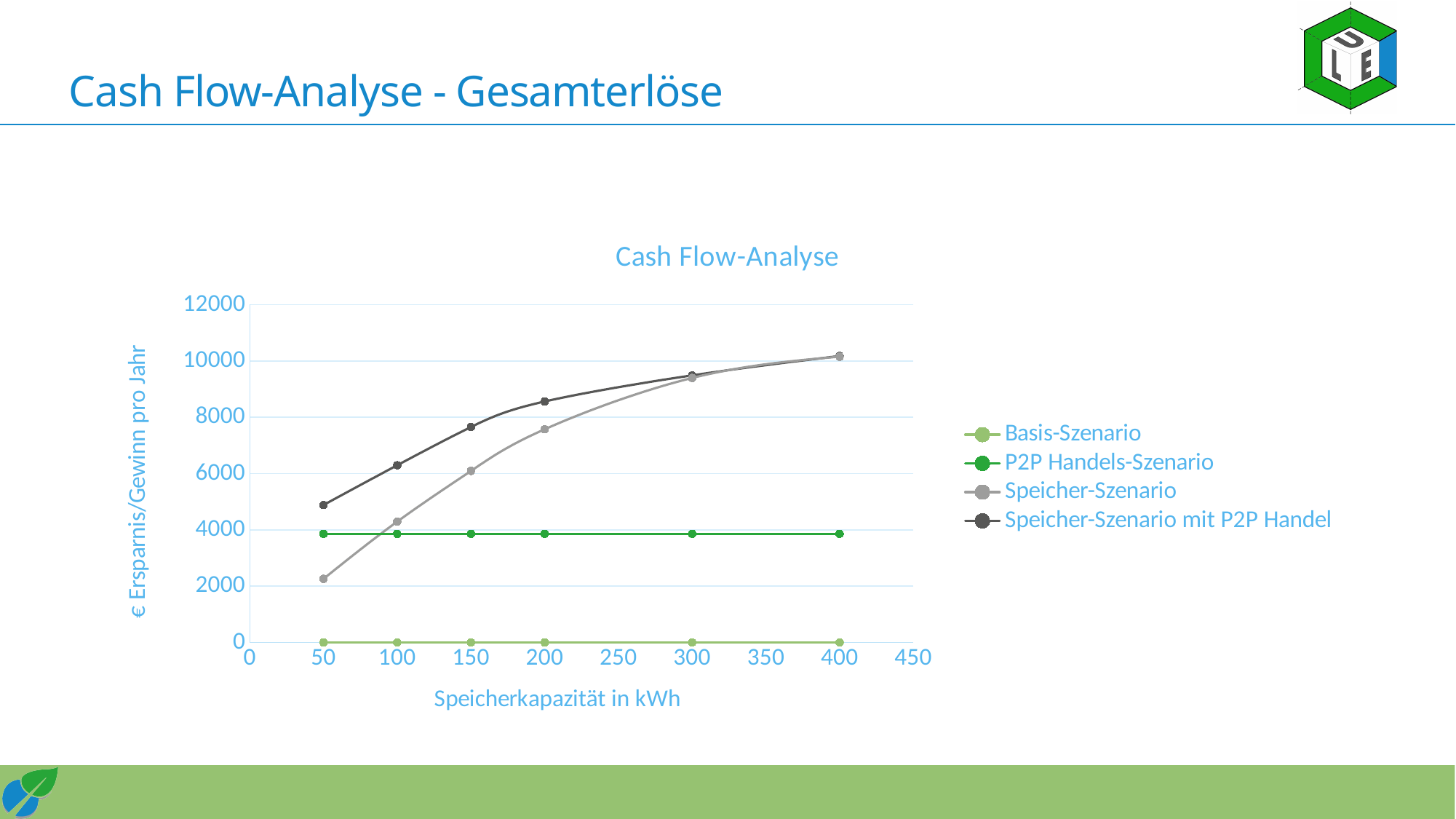
At 150 kWh, which series has the higher value: Speicher-Szenario or Speicher-Szenario mit P2P Handel? Speicher-Szenario mit P2P Handel What is the value of the Basis-Szenario series at 50 kWh? 0 Is the value for Speicher-Szenario mit P2P Handel at 100 kWh greater or less than 6000? greater What kind of chart is shown on the slide? line chart At 50 kWh, which series has the higher value: P2P Handels-Szenario or Speicher-Szenario? P2P Handels-Szenario How many series does the legend list? 4 Which series has the lowest values across all storage capacities? Basis-Szenario Does the Speicher-Szenario series rise or fall as storage capacity increases? rises Is the value for P2P Handels-Szenario at 200 kWh greater or less than 2000? greater How many data points are plotted for the Speicher-Szenario series? 6 What is the title of the x axis? Speicherkapazität in kWh Is the value for Speicher-Szenario at 50 kWh greater or less than 4000? less